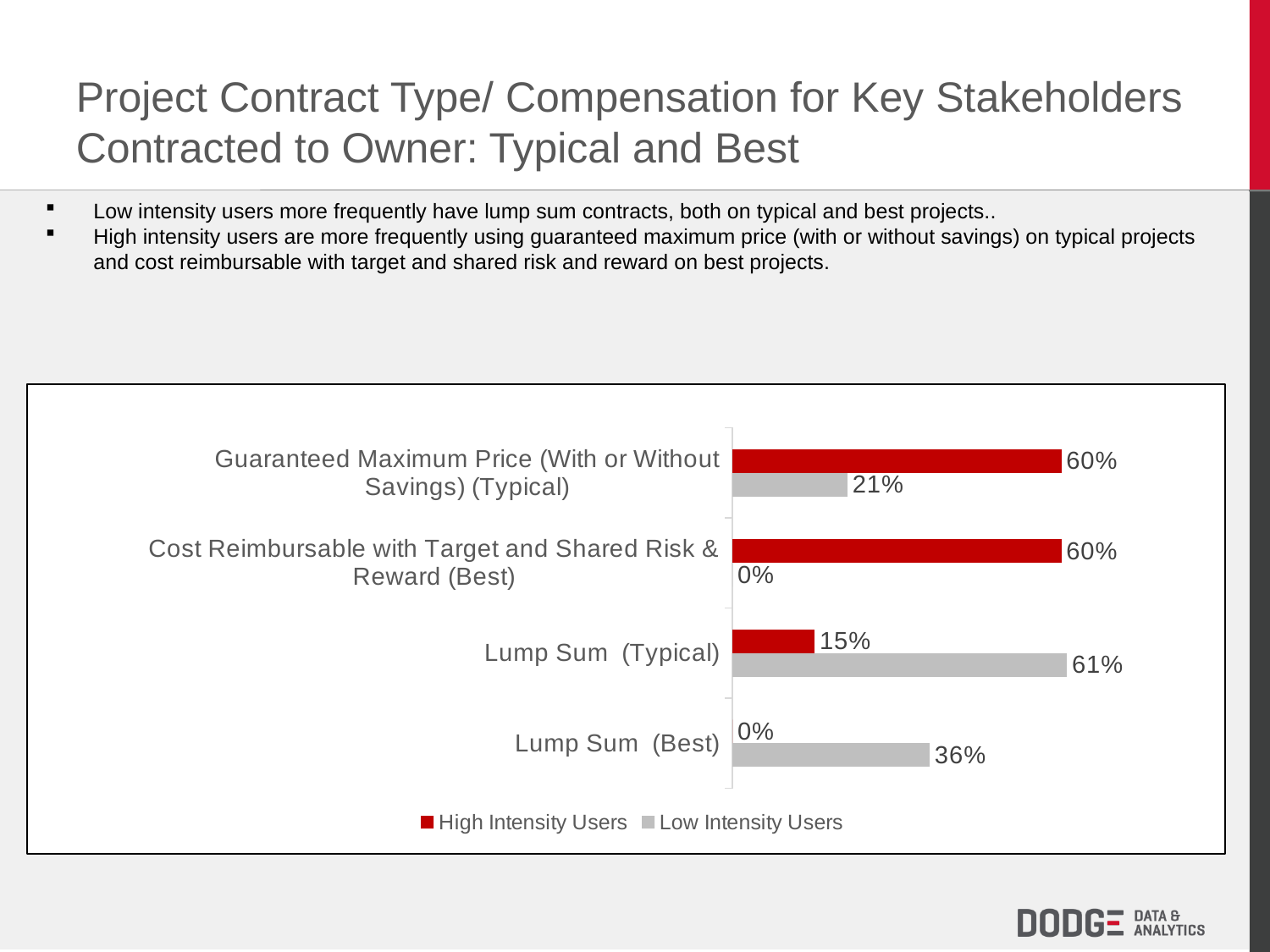
What is the value for Low Intensity Users for Lump Sum (Typical)? 61% How many categories are shown on the chart? 4 What is the value for High Intensity Users for Guaranteed Maximum Price (With or Without Savings) (Typical)? 60% How many series does the legend list? 2 What is the value for Low Intensity Users for Lump Sum (Best)? 36% Which category has the highest value for Low Intensity Users? Lump Sum (Typical) What is the value for High Intensity Users for Cost Reimbursable with Target and Shared Risk & Reward (Best)? 60% What kind of chart is shown on the slide? Bar chart What is the difference between Low Intensity Users and High Intensity Users for Lump Sum (Typical)? 46% Which category has the lowest value for Low Intensity Users? Cost Reimbursable with Target and Shared Risk & Reward (Best) What is the difference between High Intensity Users and Low Intensity Users for Guaranteed Maximum Price (With or Without Savings) (Typical)? 39% For Lump Sum (Best), which series has the larger value, High Intensity Users or Low Intensity Users? Low Intensity Users